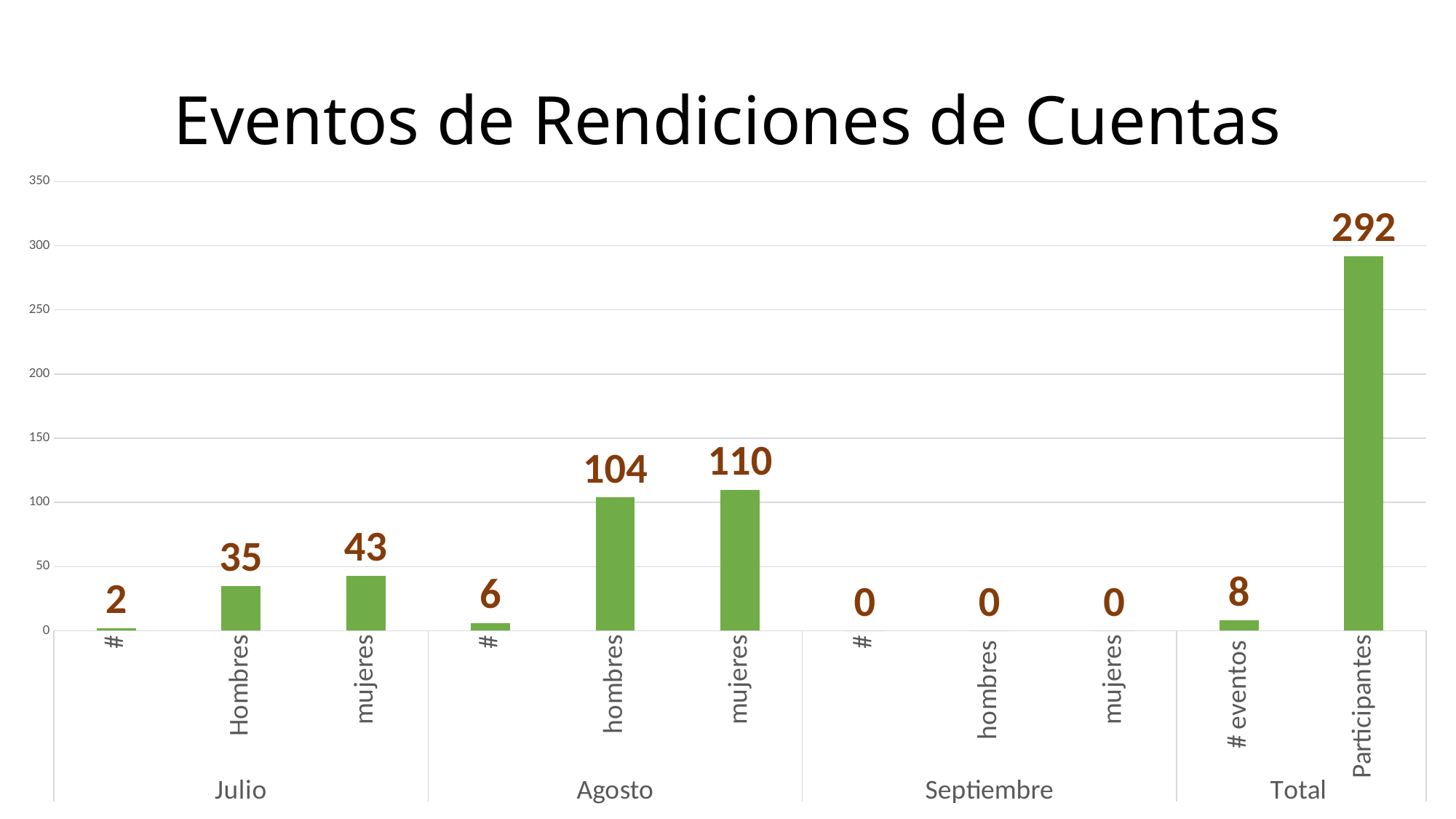
Which bar has the highest value? Participantes (Total) What is the value for # eventos under Total? 8 What is the value for Participantes under Total? 292 What is the value for mujeres in Agosto? 110 What is the difference between mujeres in Agosto and mujeres in Julio? 67 What is the value for Hombres in Julio? 35 What is the difference between mujeres and hombres in Agosto? 6 Which is larger, hombres in Agosto or mujeres in Julio? hombres in Agosto What kind of chart is shown? Bar chart What is the title of the chart? Eventos de Rendiciones de Cuentas Is the value for Participantes greater or less than 250? greater